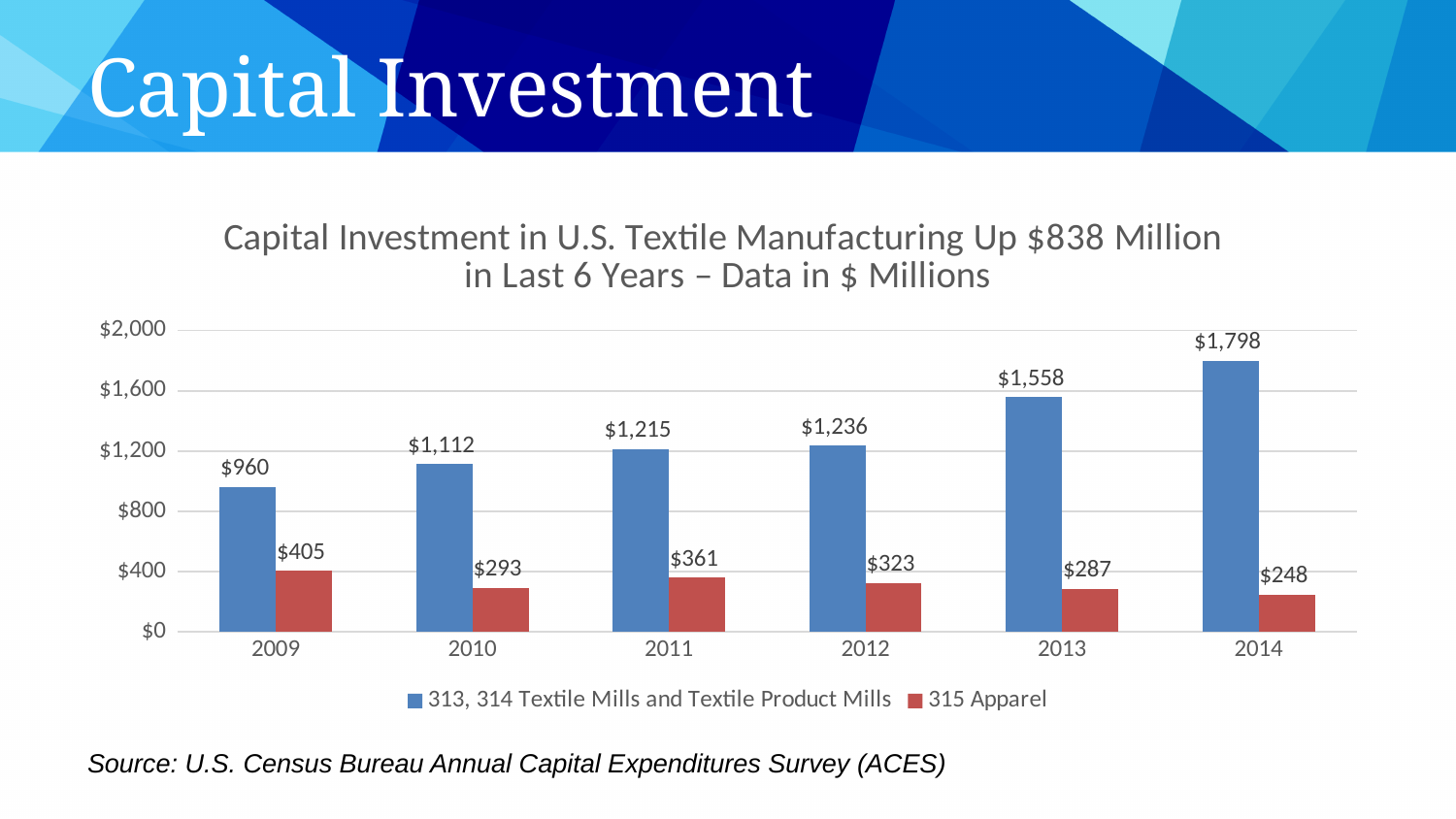
What kind of chart is shown on the slide? bar chart What is the value for 315 Apparel in 2009? $405 How many years are shown on the x axis? 6 What is the value for 313, 314 Textile Mills and Textile Product Mills in 2014? $1,798 What is the value for 313, 314 Textile Mills and Textile Product Mills in 2011? $1,215 Which is larger, the 315 Apparel value in 2011 or in 2012? 2011 Do the values for 315 Apparel rise or fall from 2011 to 2014? fall Which year has the lowest value for 315 Apparel? 2014 Is the value for 313, 314 Textile Mills and Textile Product Mills in 2013 greater or less than $1,200? greater Which year has the highest value for 313, 314 Textile Mills and Textile Product Mills? 2014 How many series does the legend list? 2 What is the difference between the 313, 314 Textile Mills and Textile Product Mills values in 2014 and 2009? $838